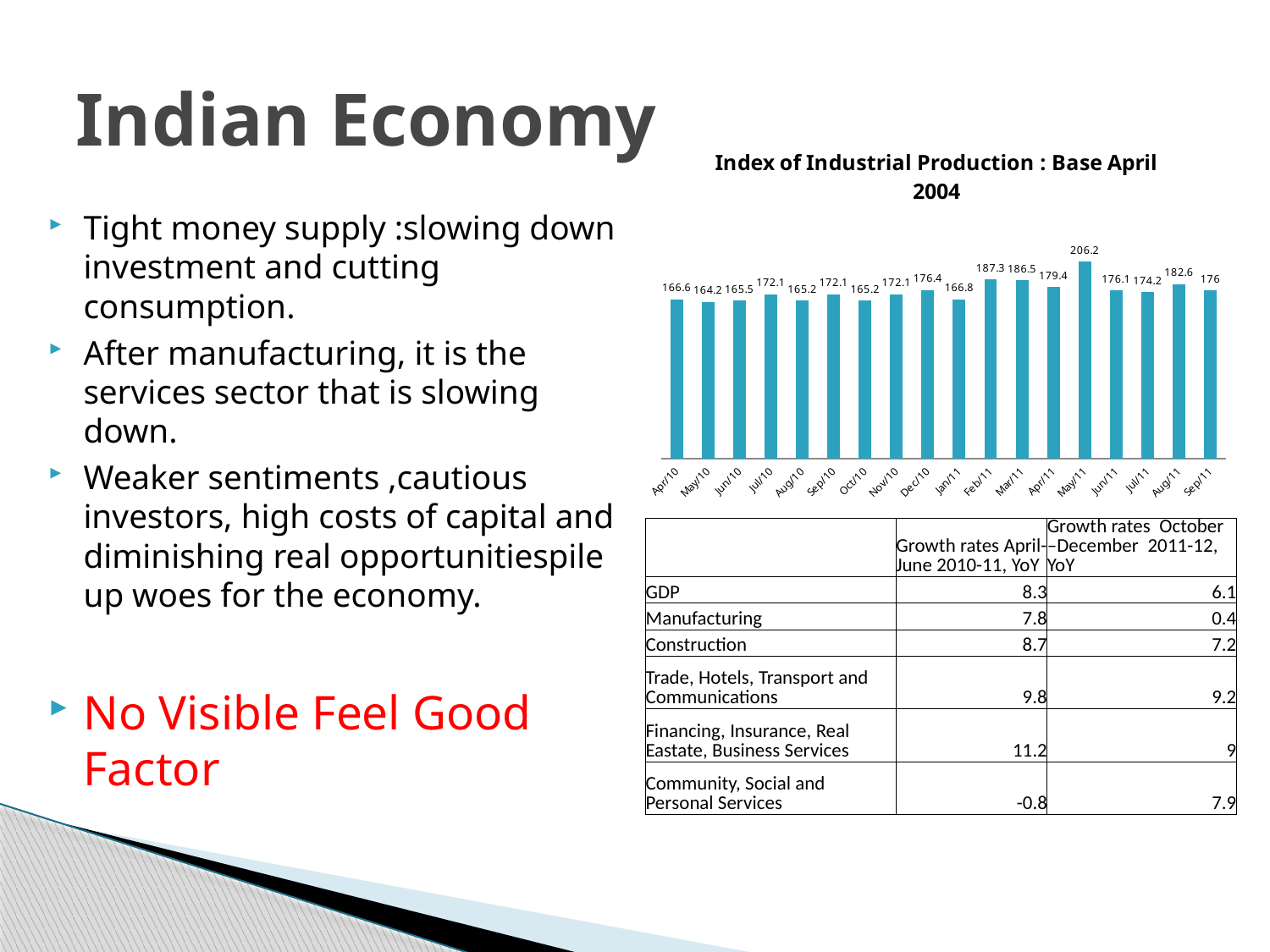
What is the difference between the Index of Industrial Production values for May/11 and Apr/11? 26.8 How many months are plotted in the Index of Industrial Production chart? 18 What is the title of the chart on the slide? Index of Industrial Production : Base April 2004 What is the difference between the Index of Industrial Production values for Feb/11 and Mar/11? 0.8 What type of chart is used to show the Index of Industrial Production? bar chart What is the Index of Industrial Production value for May/11? 206.2 What is the Index of Industrial Production value for Sep/11? 176 What is the Index of Industrial Production value for Feb/11? 187.3 What is the Index of Industrial Production value for Apr/10? 166.6 Which month has the lowest Index of Industrial Production value? May/10 Which month has the highest Index of Industrial Production value? May/11 Which is larger, the Index of Industrial Production value for Aug/11 or for Sep/11? Aug/11